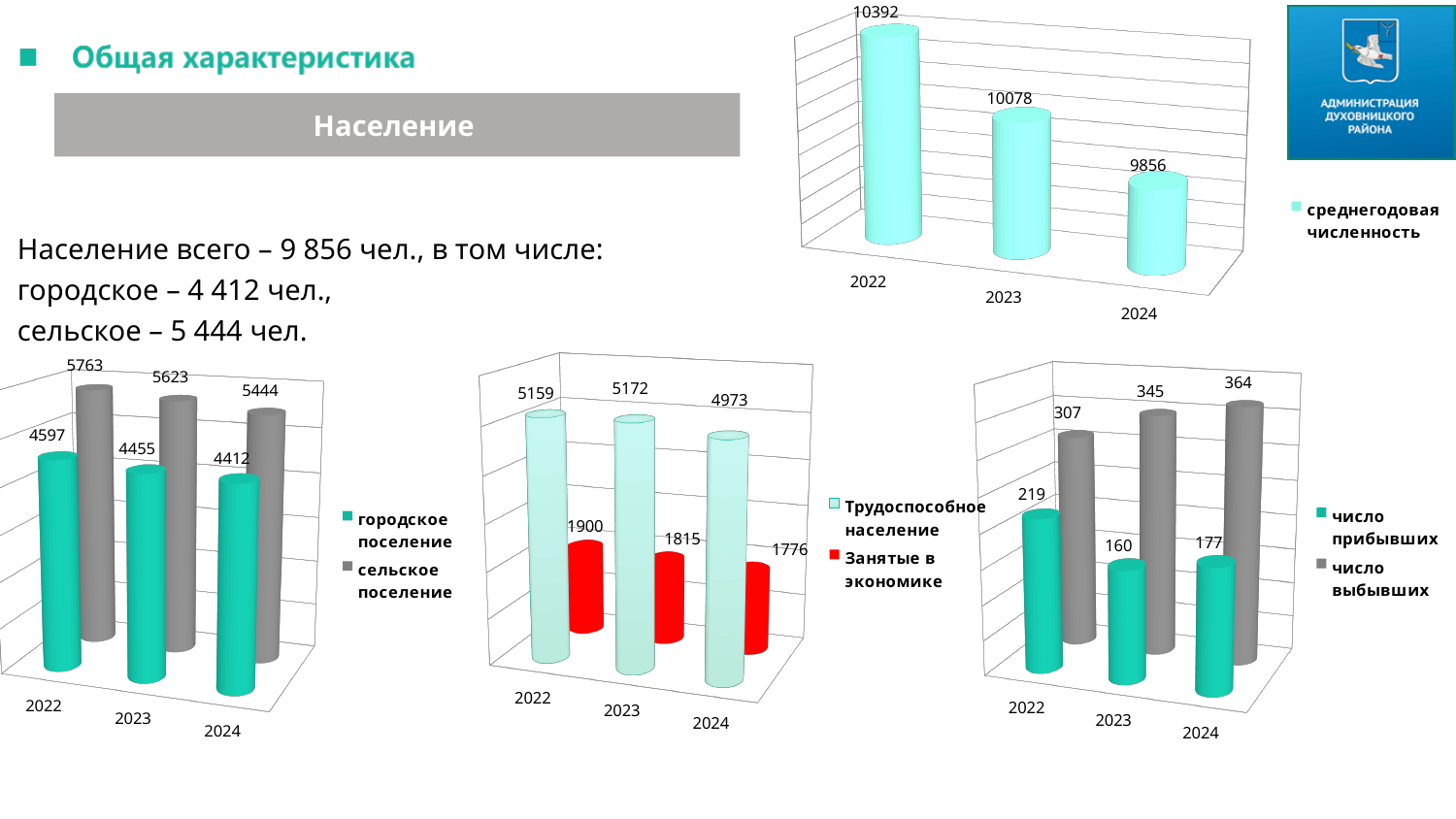
In the bottom-left chart, what is the value for сельское поселение in 2023? 5623 In the bottom-middle chart, which year has the highest value for Трудоспособное население? 2023 In the bottom-right chart, what is the value for число выбывших in 2024? 364 In the bottom-left chart, what is the difference between сельское поселение and городское поселение in 2024? 1032 In the top-right chart (среднегодовая численность), which year has the lowest value? 2024 In the bottom-left chart, how many series does the legend list? 2 What kind of chart is the bottom-right chart? bar chart In the top-right chart (среднегодовая численность), what is the value for 2022? 10392 In the bottom-right chart, which is larger in 2022: число прибывших or число выбывших? число выбывших In the top-right chart (среднегодовая численность), do the values rise or fall from 2022 to 2024? fall In the bottom-middle chart, what is the value for Занятые в экономике in 2022? 1900 In the bottom-middle chart, what colour are the bars for Занятые в экономике? red